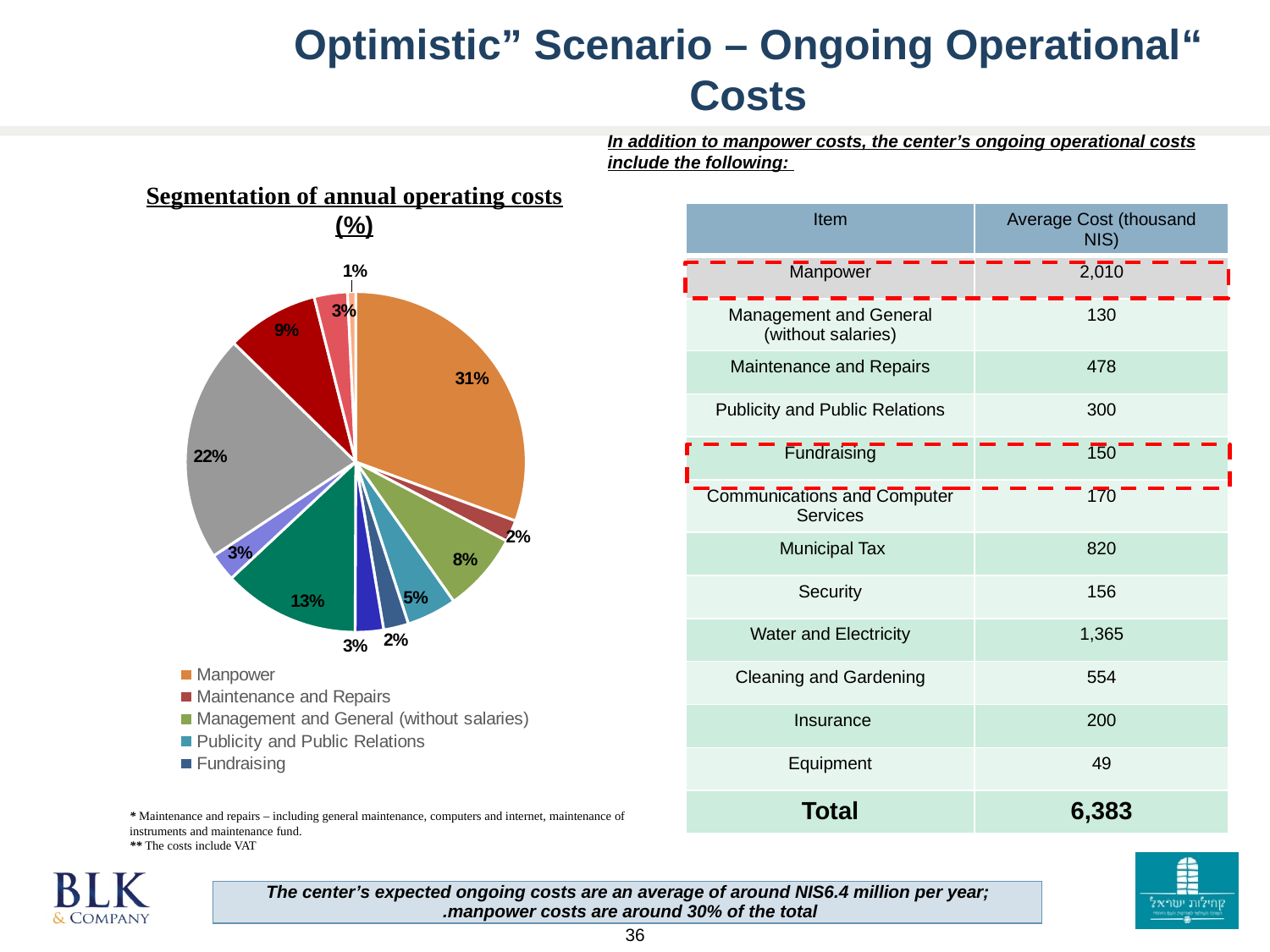
What kind of chart is shown on the left of the slide? Pie chart In the pie chart, is the slice labelled 31% larger or smaller than the slice labelled 22%? Larger Is the Manpower share in the pie chart greater or less than 30%? greater How many entries does the legend of the pie chart list? 5 What is the smallest percentage labelled on any slice of the pie chart? 1% Which legend entry of the pie chart corresponds to the largest slice? Manpower In the pie chart, what share is labelled on the Manpower slice? 31% What is the title of the pie chart? Segmentation of annual operating costs (%) What is the difference in percentage points between the largest slice (31%) and the second-largest slice (22%) of the pie chart? 9 What is the largest percentage labelled on any slice of the pie chart? 31% How many slices does the pie chart have? 12 What colour represents Manpower in the pie chart legend? Orange